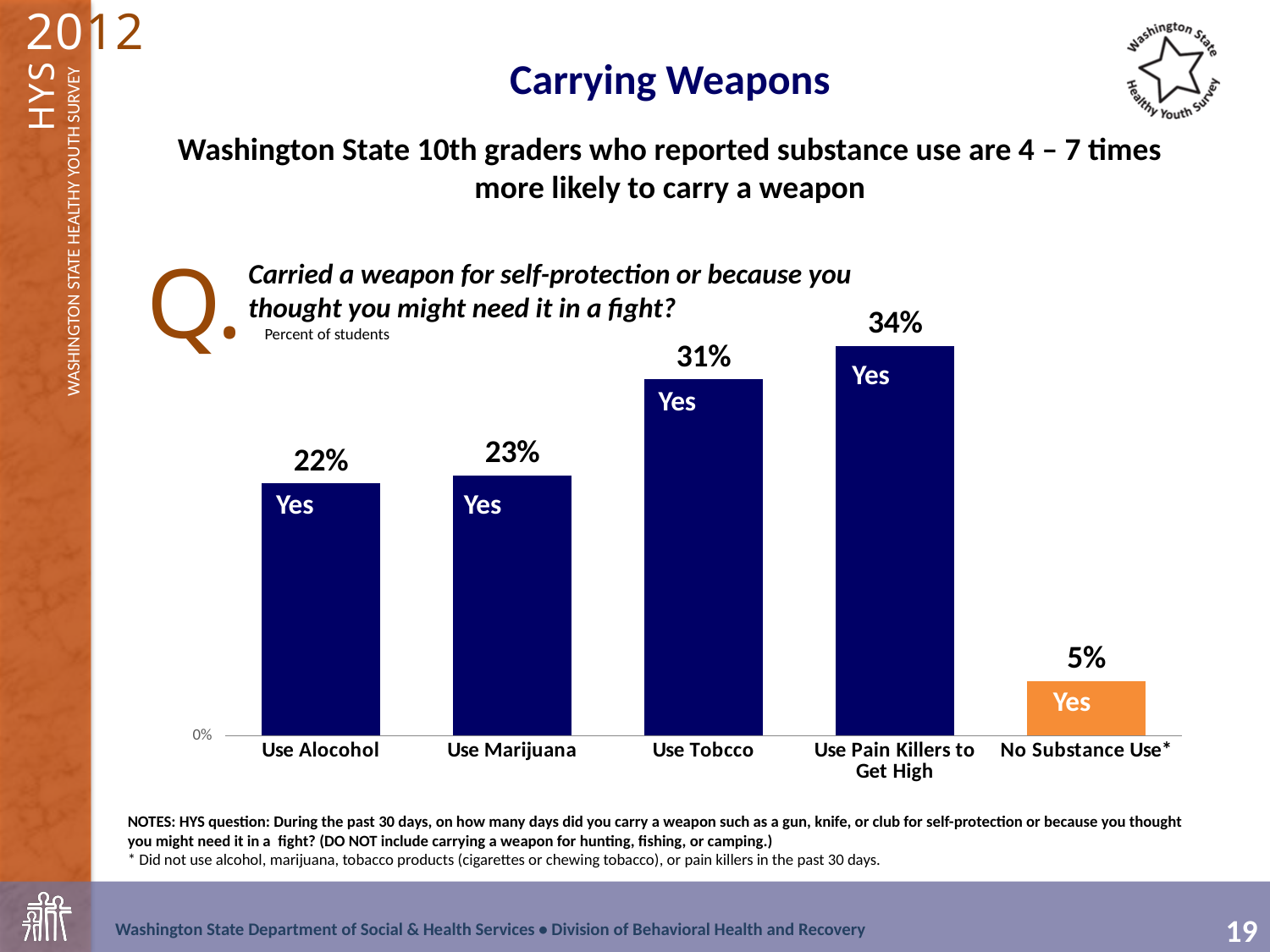
What kind of chart is shown on the slide? Bar chart Which is larger, the value for Use Tobcco or the value for Use Alocohol? Use Tobcco What is the value shown for the Use Marijuana bar? 23% What percentage is shown for No Substance Use*? 5% Which category has the highest percentage of students carrying a weapon? Use Pain Killers to Get High What percentage of students who use alcohol reported carrying a weapon? 22% How many categories are shown on the chart? 5 Which category has the lowest percentage? No Substance Use* What is the value for Use Pain Killers to Get High? 34% What is the difference between the Use Pain Killers to Get High value and the No Substance Use* value? 29% What percentage is shown for Use Tobcco? 31% Which bar is coloured orange rather than dark blue? No Substance Use*